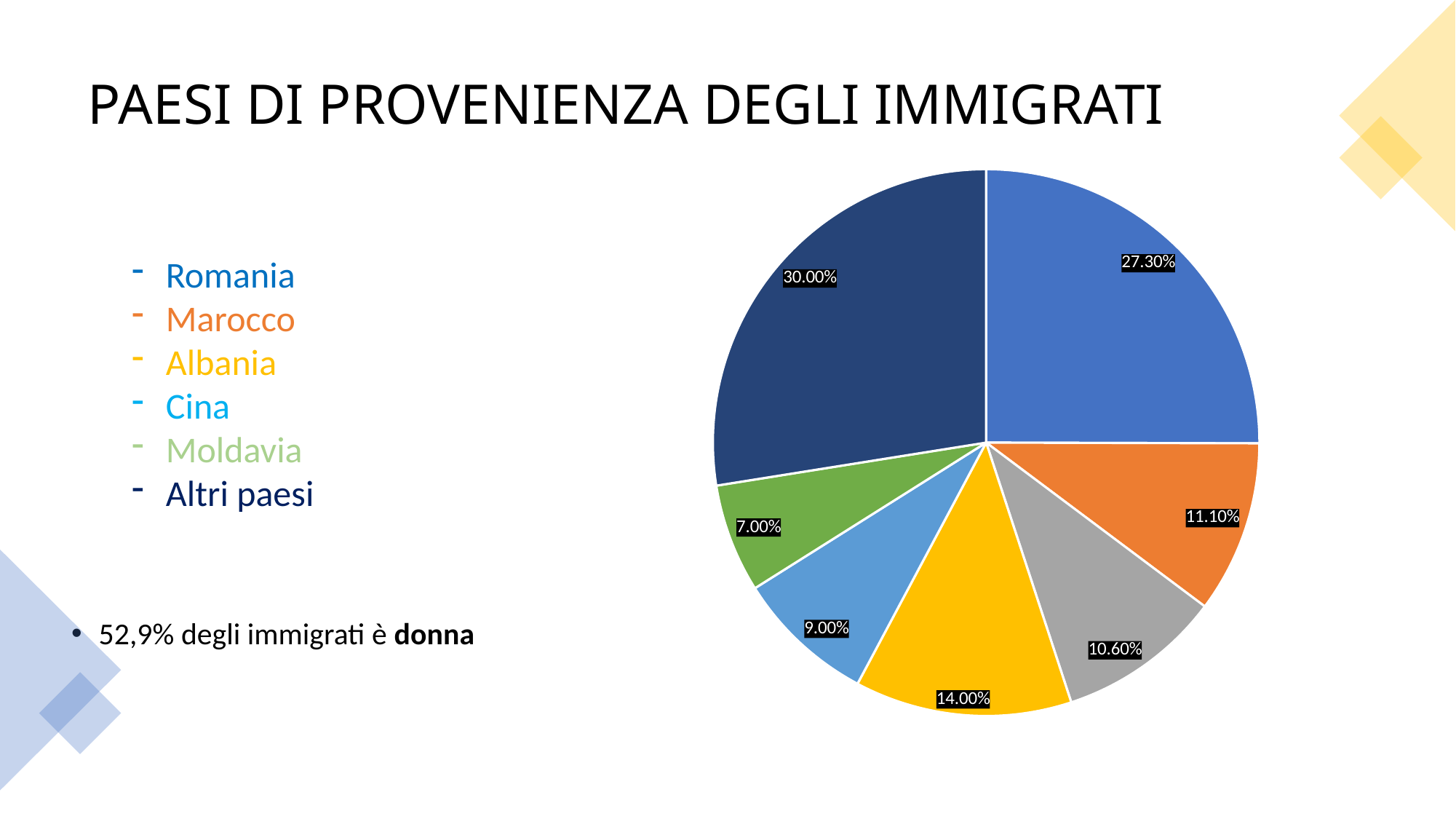
What share of the pie does the slice for Romania (blue) represent? 27.30% What is the value of the light blue slice (Cina) in the pie chart? 9.00% What is the title of the slide containing the pie chart? PAESI DI PROVENIENZA DEGLI IMMIGRATI What is the difference between the dark navy slice (Altri paesi) and the blue slice (Romania)? 2.70% What is the smallest slice's value in the pie chart? 7.00% What is the largest slice's value in the pie chart? 30.00% What is the value of the orange slice (Marocco) in the pie chart? 11.10% What is the value of the gray slice in the pie chart? 10.60% What kind of chart is shown on the slide? pie chart How many slices does the pie chart have? 7